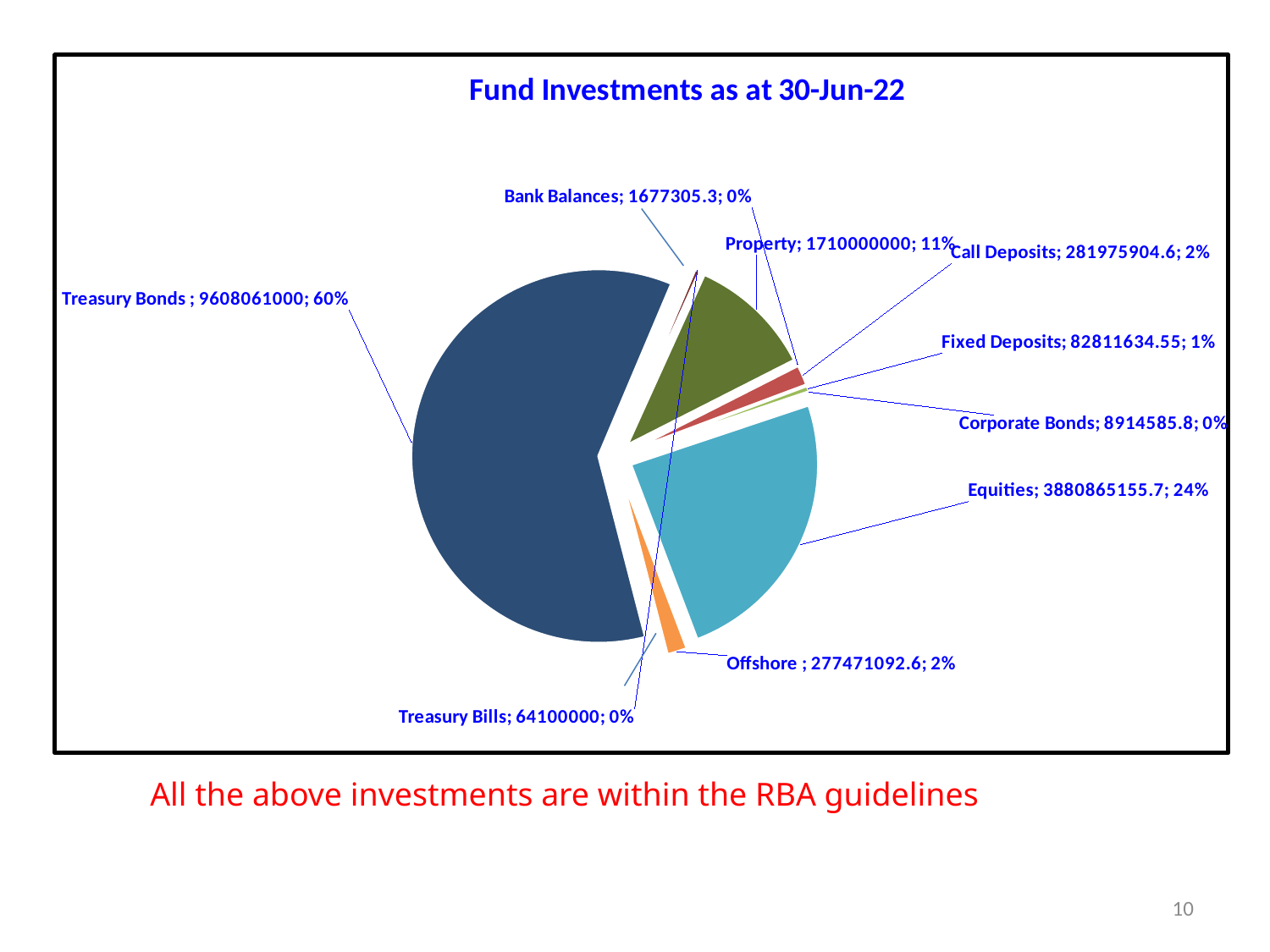
What is the difference between the values for Property and Treasury Bills? 1645900000 What is the value shown for Equities? 3880865155.7 What is the title of the chart? Fund Investments as at 30-Jun-22 Which is larger, Property or Equities? Equities Which category has the largest slice of the pie? Treasury Bonds What is the value shown for Treasury Bonds? 9608061000 How many categories (slices) does the pie chart show? 9 What is the value shown for Offshore? 277471092.6 What kind of chart is shown on the slide? Pie chart What share of the pie does Equities represent? 24% What is the value shown for Property? 1710000000 What share of the pie does Treasury Bonds represent? 60%